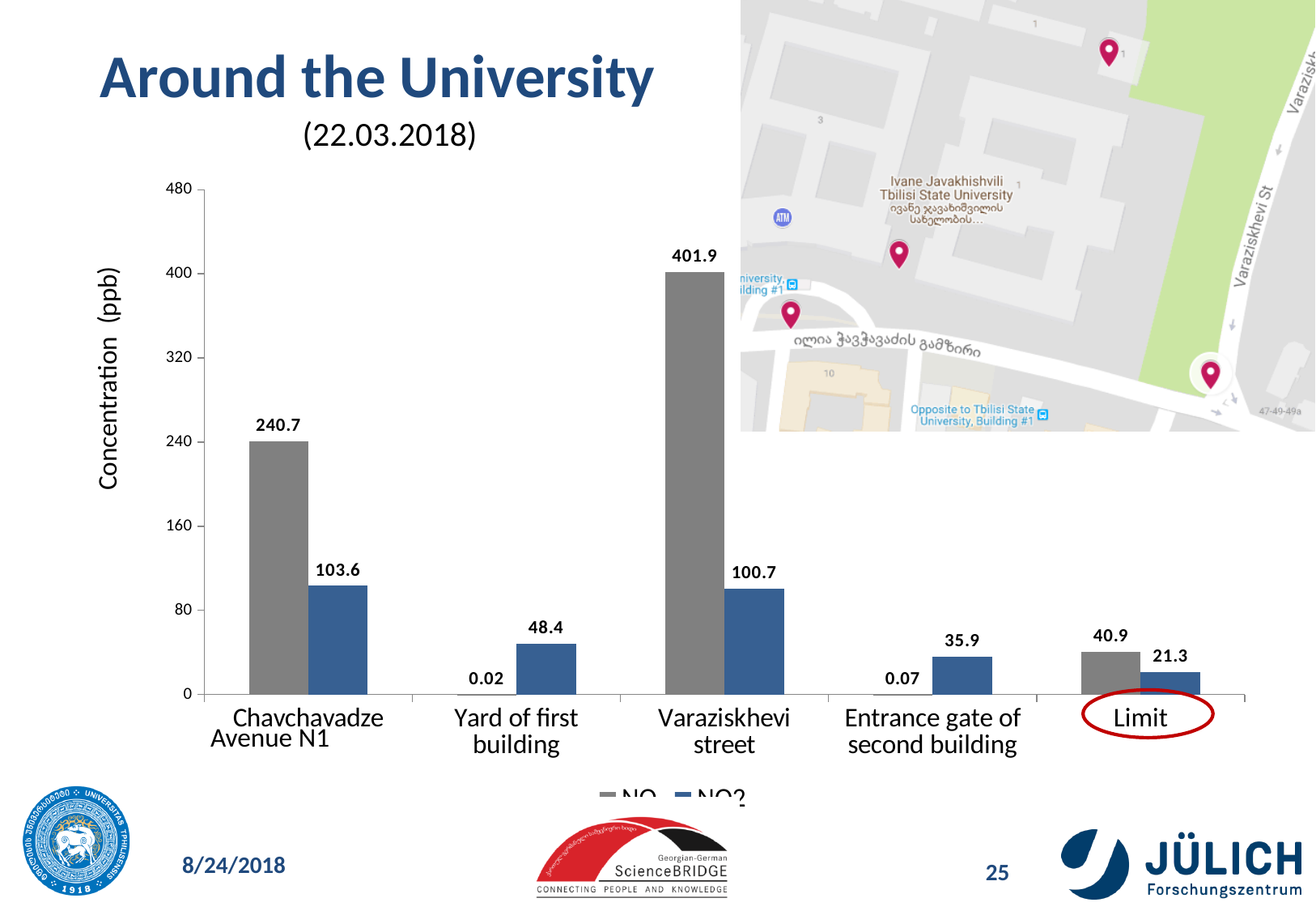
How many categories are shown on the x axis of the chart? 5 Which category has the highest NO (gray bar) concentration? Varaziskhevi street What is the NO2 (blue bar) concentration at Chavchavadze Avenue N1? 103.6 What is the label of the y axis of the chart? Concentration (ppb) What is the difference between the NO (gray) values at Varaziskhevi street and Chavchavadze Avenue N1? 161.2 Which is larger: the NO2 (blue) value at Chavchavadze Avenue N1 or at Varaziskhevi street? Chavchavadze Avenue N1 What kind of chart is shown on the slide? Bar chart What is the NO2 (blue bar) value for the Limit category? 21.3 Which category has the lowest NO2 (blue bar) concentration? Limit What is the NO (gray bar) value at the Yard of first building? 0.02 How many series does the chart's legend list? 2 What is the NO (gray bar) concentration at Varaziskhevi street? 401.9